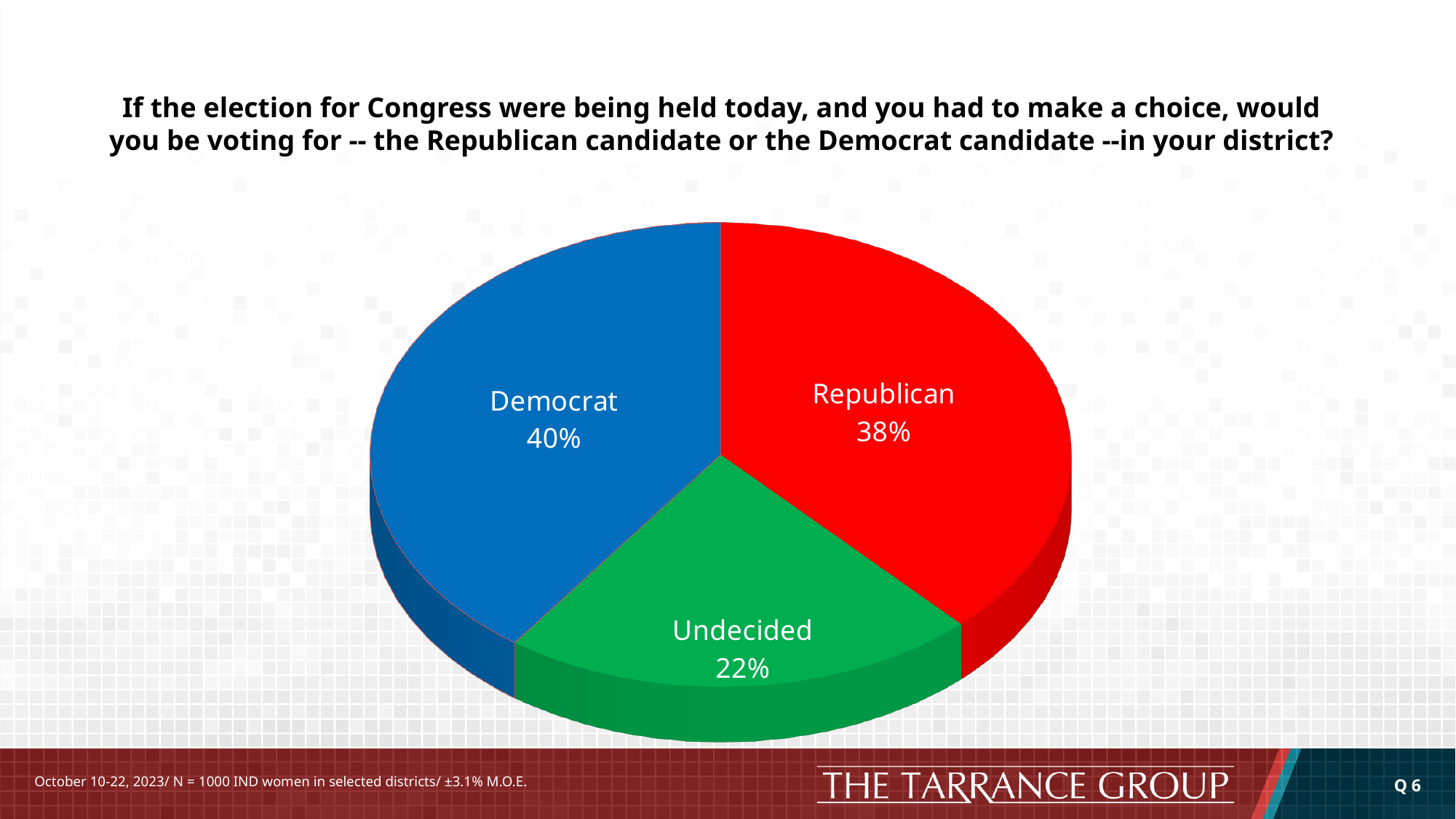
Which is larger, the Republican share or the Undecided share? Republican What is the difference in percentage points between the Republican and Undecided shares? 16 What is the difference in percentage points between the Democrat and Republican shares? 2 What percentage of respondents said they would vote for the Democrat candidate? 40% How many slices does the pie chart have? 3 What colour is the Republican slice? Red What colour is the Undecided slice? Green What kind of chart is shown on the slide? Pie chart Which category has the largest share of the pie? Democrat What percentage of respondents are Undecided? 22% What percentage of respondents said they would vote for the Republican candidate? 38% Which category has the smallest share of the pie? Undecided